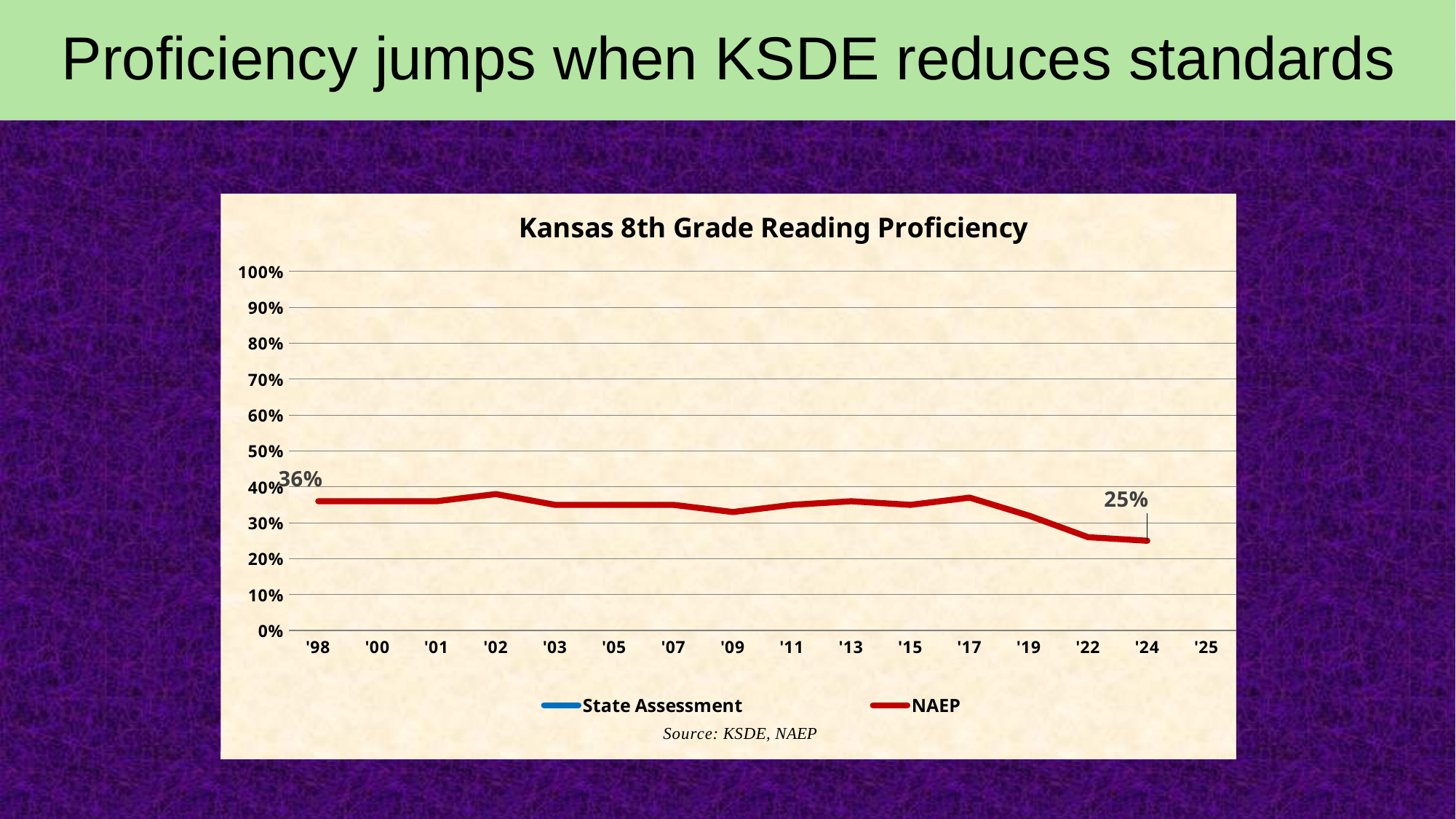
What kind of chart is shown on the slide? line chart Is the NAEP value for '17 greater or less than 40%? less Is the NAEP value for '22 greater or less than 30%? less How many year labels are shown on the x axis? 16 Which year has the larger NAEP value, '98 or '24? '98 Is the NAEP value for '02 greater or less than 30%? greater What is the title of the chart? Kansas 8th Grade Reading Proficiency What is the NAEP value for '24 in the Kansas 8th Grade Reading Proficiency chart? 25% What is the NAEP value for '98 in the Kansas 8th Grade Reading Proficiency chart? 36% How many series does the legend list? 2 By how many percentage points did the NAEP value fall from '98 to '24? 11 percentage points Does the NAEP line rise or fall from '17 to '24? fall